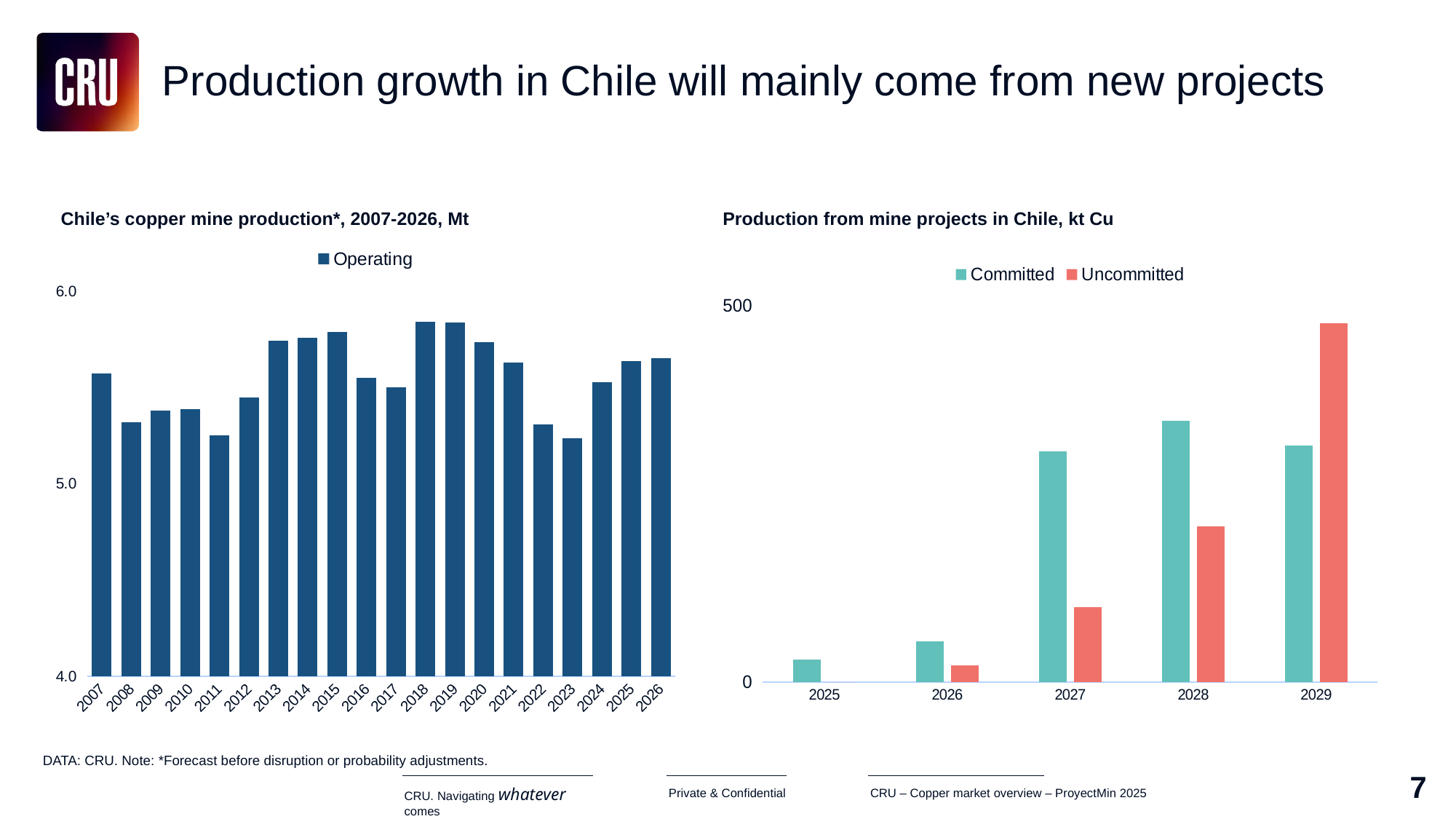
In the "Chile's copper mine production*, 2007-2026, Mt" chart, is the value for 2011 greater or less than 5.0? greater How many series does the legend of the "Chile's copper mine production*, 2007-2026, Mt" chart list? 1 In the "Production from mine projects in Chile, kt Cu" chart, which year has the lowest Committed value? 2025 How many years are shown on the x axis of the "Production from mine projects in Chile, kt Cu" chart? 5 How many series does the legend of the "Production from mine projects in Chile, kt Cu" chart list? 2 In the "Production from mine projects in Chile, kt Cu" chart, which year has the highest Uncommitted value? 2029 What is the name of the series in the legend of the "Chile's copper mine production*, 2007-2026, Mt" chart? Operating In the "Chile's copper mine production*, 2007-2026, Mt" chart, which is larger, the value for 2021 or the value for 2022? 2021 In the "Production from mine projects in Chile, kt Cu" chart, is the Uncommitted value for 2029 greater or less than 500? less What kind of chart is "Chile's copper mine production*, 2007-2026, Mt"? bar chart In the "Chile's copper mine production*, 2007-2026, Mt" chart, which is larger, the value for 2013 or the value for 2008? 2013 How many years are shown on the x axis of the "Chile's copper mine production*, 2007-2026, Mt" chart? 20